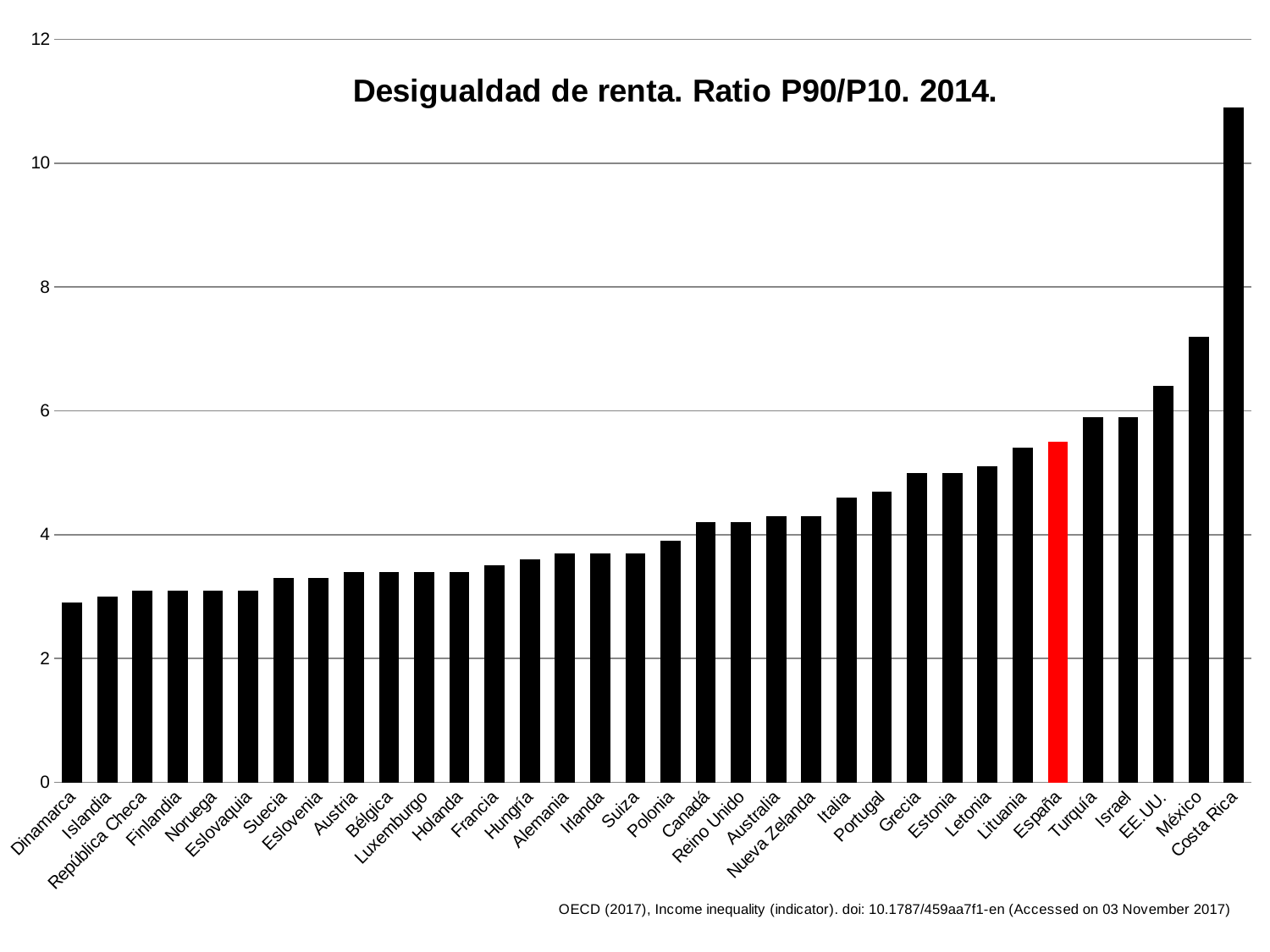
Is the value for Italia greater or less than 4? greater Which has the larger value, Costa Rica or México? Costa Rica What is the title of the chart? Desigualdad de renta. Ratio P90/P10. 2014. Which country has the lowest value in the chart? Dinamarca How many countries are shown in the chart? 34 Which country's bar is highlighted in red? España Which country has the highest value in the chart? Costa Rica Which has the larger value, España or Italia? España Is the value for México greater or less than 8? less Is the value for Costa Rica greater or less than 10? greater What kind of chart is shown on the slide? Bar chart